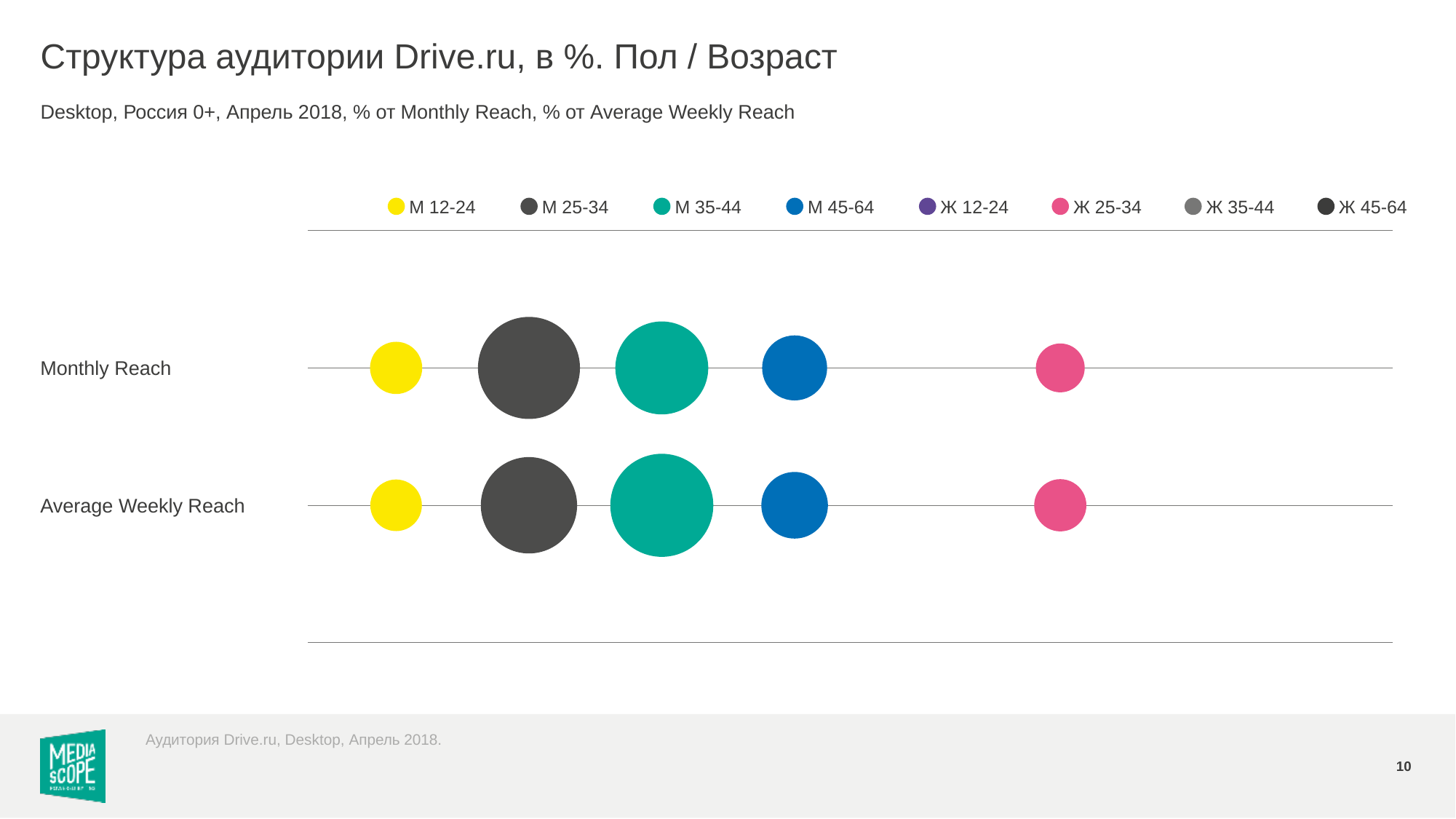
How many series does the legend list? 8 In the Monthly Reach row, which bubble is larger: М 25-34 or М 45-64? М 25-34 What are the two categories plotted on the chart? Monthly Reach and Average Weekly Reach In the Average Weekly Reach row, which bubble is larger: М 35-44 or М 12-24? М 35-44 How many rows (categories) are plotted on the chart? 2 In the Average Weekly Reach row, which bubble is larger: М 45-64 or М 25-34? М 25-34 Which legend entry is shown in yellow? М 12-24 What kind of chart is shown on the slide? bubble chart